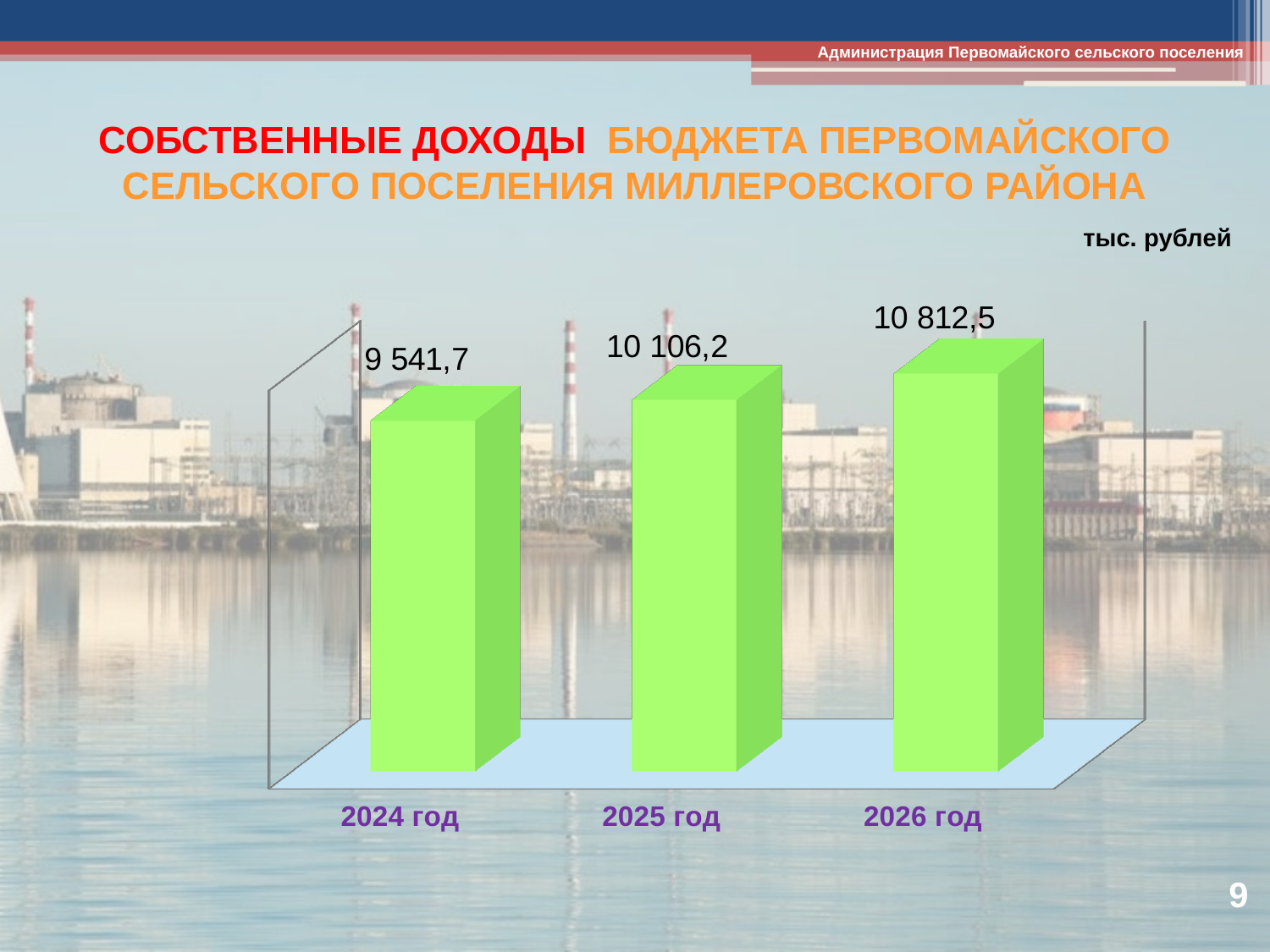
What is the value for 2024 год? 9 541,7 What is the value for 2025 год? 10 106,2 Which year has the lowest value? 2024 год What kind of chart is shown on the slide? bar chart Which is larger, the value for 2025 год or the value for 2026 год? 2026 год How many years are shown on the chart? 3 What is the difference between the values for 2025 год and 2024 год? 564,5 Which year has the highest value? 2026 год What is the difference between the values for 2026 год and 2025 год? 706,3 What is the value for 2026 год? 10 812,5 What is the difference between the values for 2026 год and 2024 год? 1 270,8 Do the values rise or fall from 2024 год to 2026 год? rise